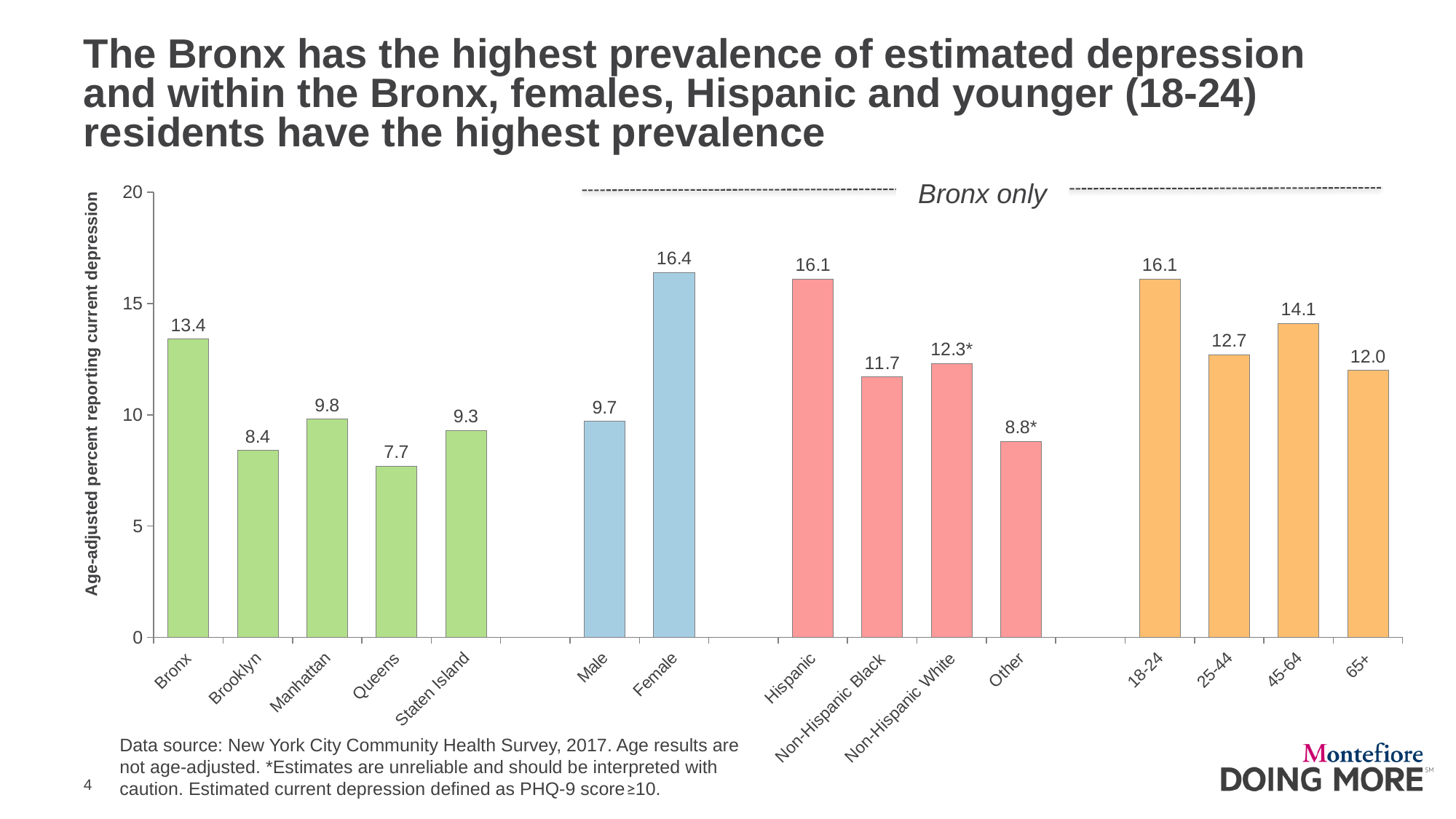
Is the value for Hispanic greater or less than 15? greater What is the difference between the Female and Male values in the Bronx? 6.7 What kind of chart is shown on the slide? Bar chart What is the value shown for Non-Hispanic Black in the Bronx? 11.7 What is the value shown for Female in the Bronx? 16.4 Which is larger, the value for Manhattan or the value for Staten Island? Manhattan How many bars are plotted on the chart in total? 15 Which borough has the lowest percent reporting current depression? Queens What is the age-adjusted percent reporting current depression for the Bronx? 13.4 Which age group in the Bronx has the highest percent reporting current depression? 18-24 What is the difference between the Bronx and Brooklyn values? 5.0 What is the label on the vertical axis of the chart? Age-adjusted percent reporting current depression